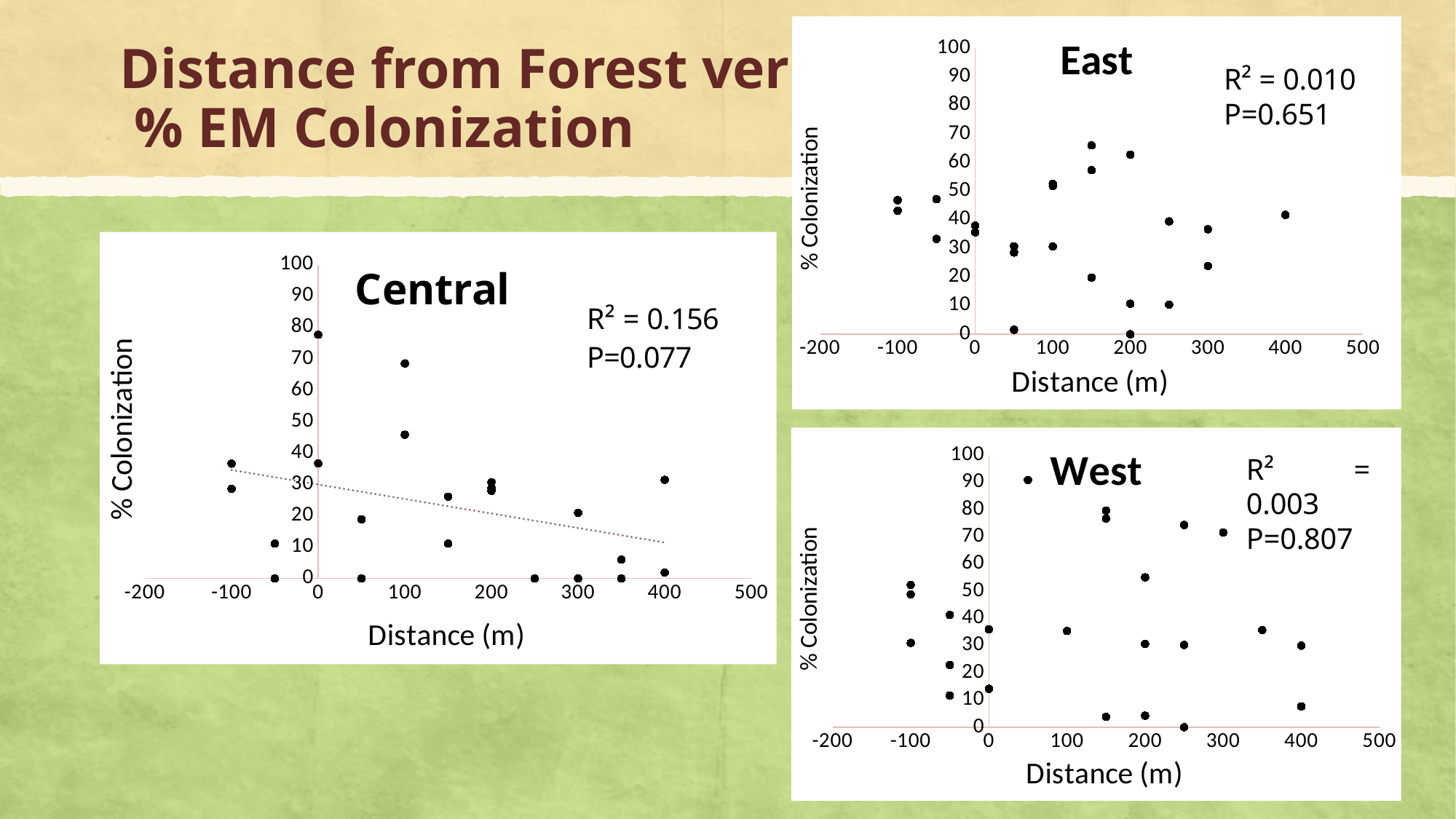
In the Central chart, does the dotted trend line rise or fall as distance increases? falls Which chart has the highest single plotted % Colonization value: Central, East, or West? West What is the P value shown on the East chart? P=0.651 In the West chart, is the highest plotted % Colonization value greater or less than 80? greater How many scatter charts are shown on the slide? 3 In the East chart, is the point at a distance of 50 m near the bottom greater or less than 10? less What kind of chart is the Central chart? scatter chart In the East chart, is the highest plotted % Colonization value greater or less than 60? greater What is the x-axis title of the West chart? Distance (m) What is the R² value shown on the Central chart? 0.156